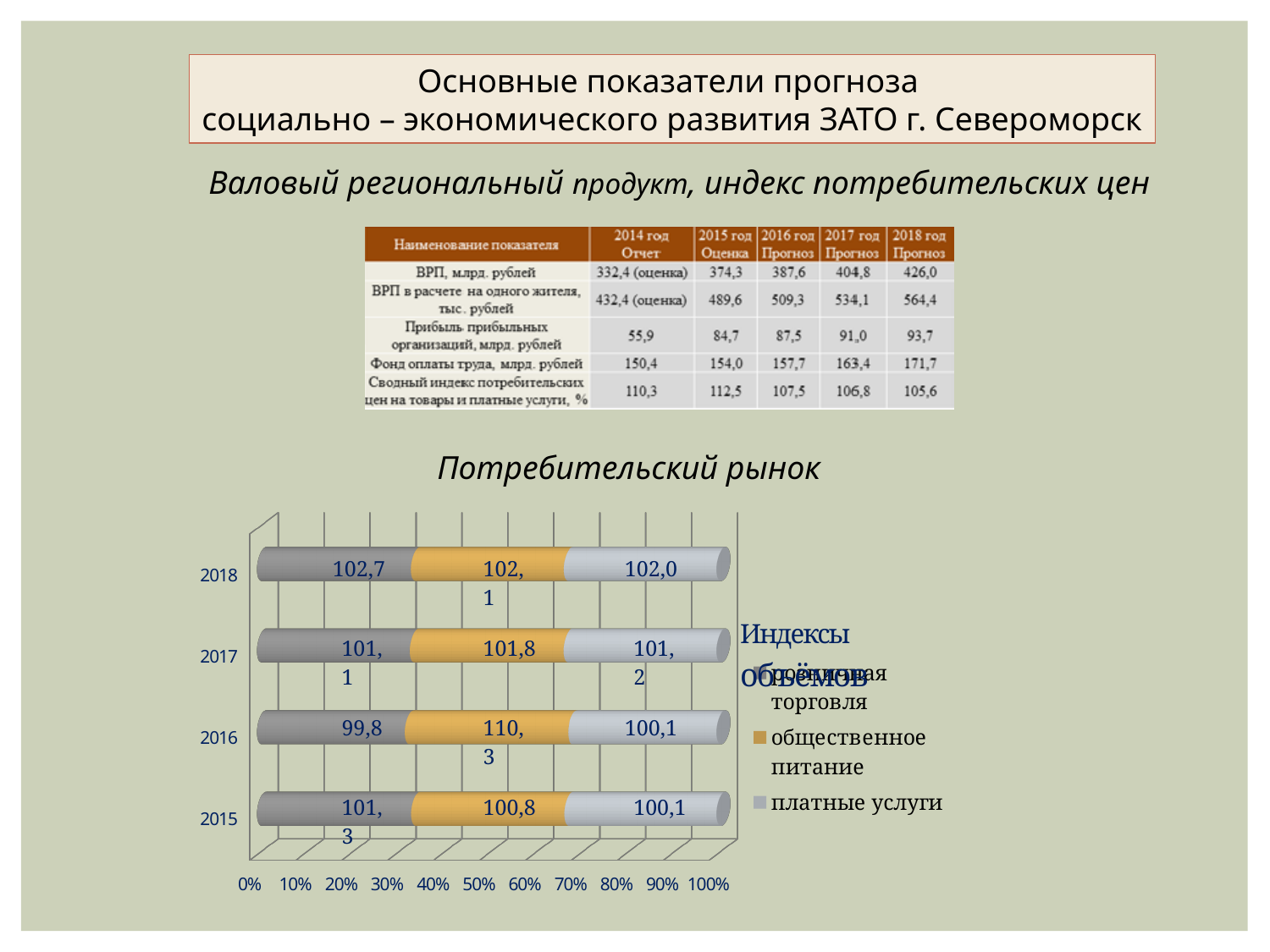
In the 'Потребительский рынок' chart, what is the value for 'общественное питание' in 2016? 110,3 In the 'Потребительский рынок' chart, which legend entry is shown in orange? общественное питание What kind of chart is shown under the heading 'Потребительский рынок'? bar chart In the 'Потребительский рынок' chart, what is the difference between the 'общественное питание' value in 2016 and in 2015? 9,5 In the 'Потребительский рынок' chart, which year has the lowest value for 'розничная торговля'? 2016 In the 'Потребительский рынок' chart, what is the value for 'платные услуги' in 2018? 102,0 In the 'Потребительский рынок' chart, which year has the highest value for 'общественное питание'? 2016 In the 'Потребительский рынок' chart, what is the value for 'общественное питание' in 2017? 101,8 In the 'Потребительский рынок' chart, which is larger in 2018: the value for 'розничная торговля' or for 'платные услуги'? розничная торговля How many years (categories) are shown on the 'Потребительский рынок' bar chart? 4 In the 'Потребительский рынок' chart, what is the value for 'розничная торговля' in 2015? 101,3 How many series does the legend of the 'Потребительский рынок' chart list? 3